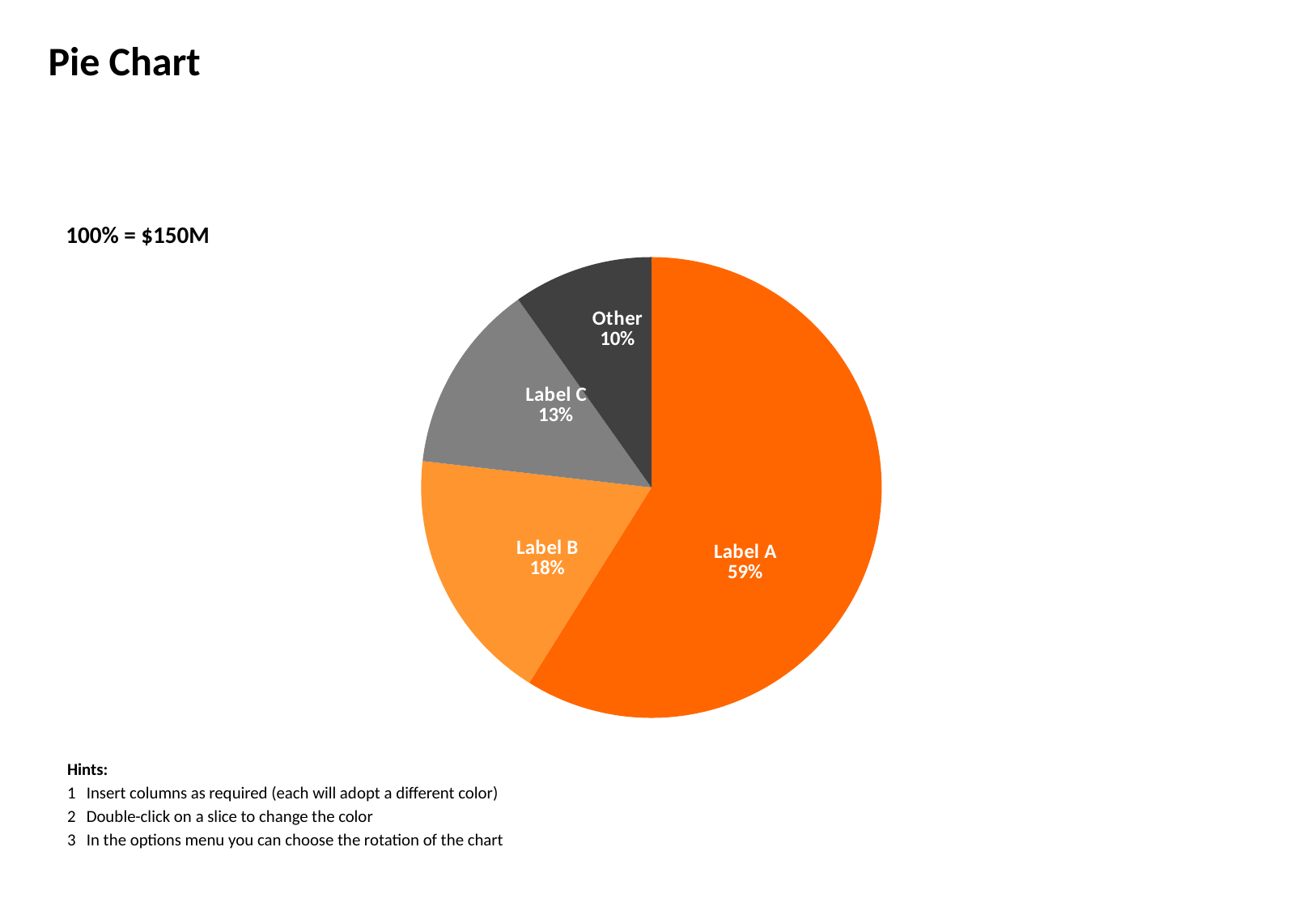
What percentage share does Label C have? 13% What is the difference in percentage points between Label A and Label B? 41 What percentage share does the Other slice have? 10% Which slice has the largest share of the pie? Label A Which is larger, the share for Label C or the share for Other? Label C What kind of chart is shown on the slide? pie chart How many slices does the pie chart have? 4 What percentage share does Label B have? 18% Which slice has the smallest share of the pie? Other What is the title of the slide? Pie Chart What total value does 100% of the pie represent, according to the slide? $150M What percentage share does Label A have? 59%